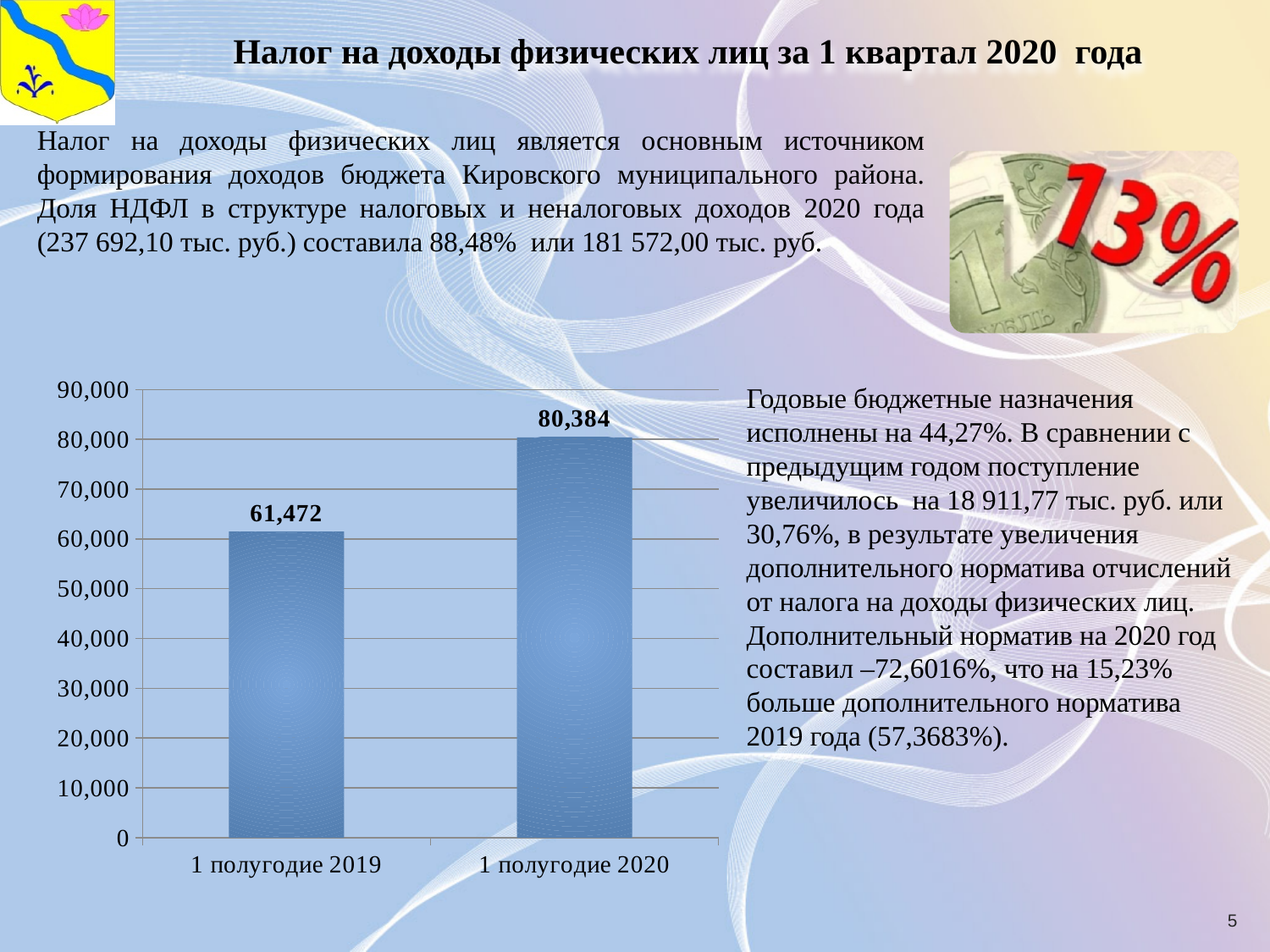
What is the maximum value shown on the vertical axis of the chart? 90,000 What is the value for 1 полугодие 2020? 80,384 Is the value for 1 полугодие 2019 greater or less than 70,000? less Which is larger, the value for 1 полугодие 2019 or for 1 полугодие 2020? 1 полугодие 2020 How many categories are shown on the chart? 2 Which category has the highest value? 1 полугодие 2020 What is the difference between the values for 1 полугодие 2020 and 1 полугодие 2019? 18,912 What kind of chart is shown on the slide? bar chart Which category has the lowest value? 1 полугодие 2019 What is the value for 1 полугодие 2019? 61,472 Is the value for 1 полугодие 2020 greater or less than 80,000? greater Do the values rise or fall from 1 полугодие 2019 to 1 полугодие 2020? rise